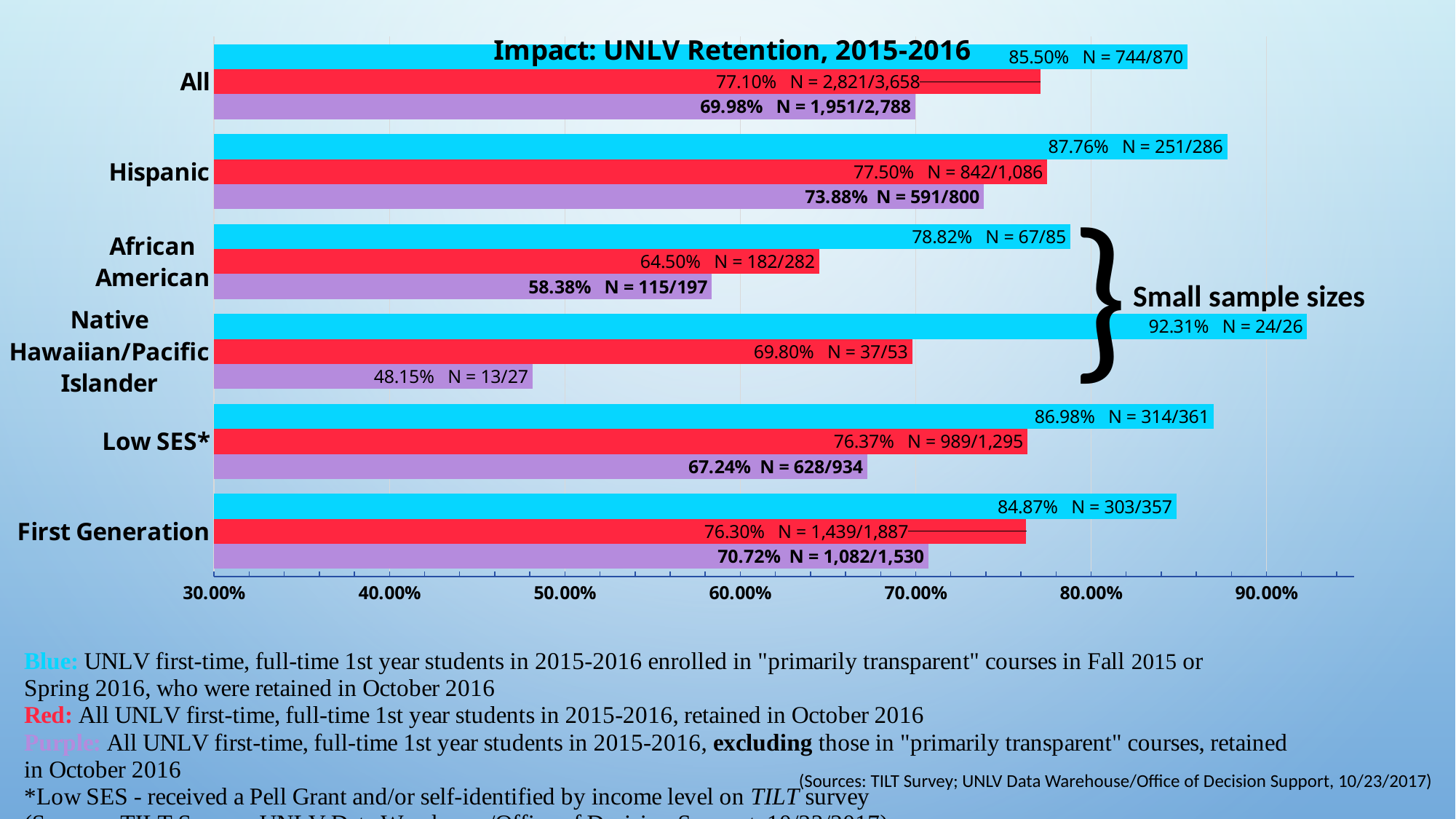
What is the retention rate shown by the purple bar for Native Hawaiian/Pacific Islander students? 48.15% What is the difference between the blue bar and the purple bar for the All category? 15.52% Which is larger for African American students: the red bar value or the purple bar value? the red bar value (64.50%) Is the blue bar value for Low SES* students greater or less than 80.00%? greater Which category has the highest blue-bar retention rate? Native Hawaiian/Pacific Islander What is the title of the chart? Impact: UNLV Retention, 2015-2016 What is the N value printed next to the blue bar for First Generation students? N = 303/357 How many categories are shown on the chart's vertical axis? 6 What is the retention rate shown by the blue bar for Hispanic students? 87.76% What is the retention rate shown by the red bar for Low SES* students? 76.37% What kind of chart is shown on the slide? bar chart Which category has the lowest purple-bar retention rate? Native Hawaiian/Pacific Islander